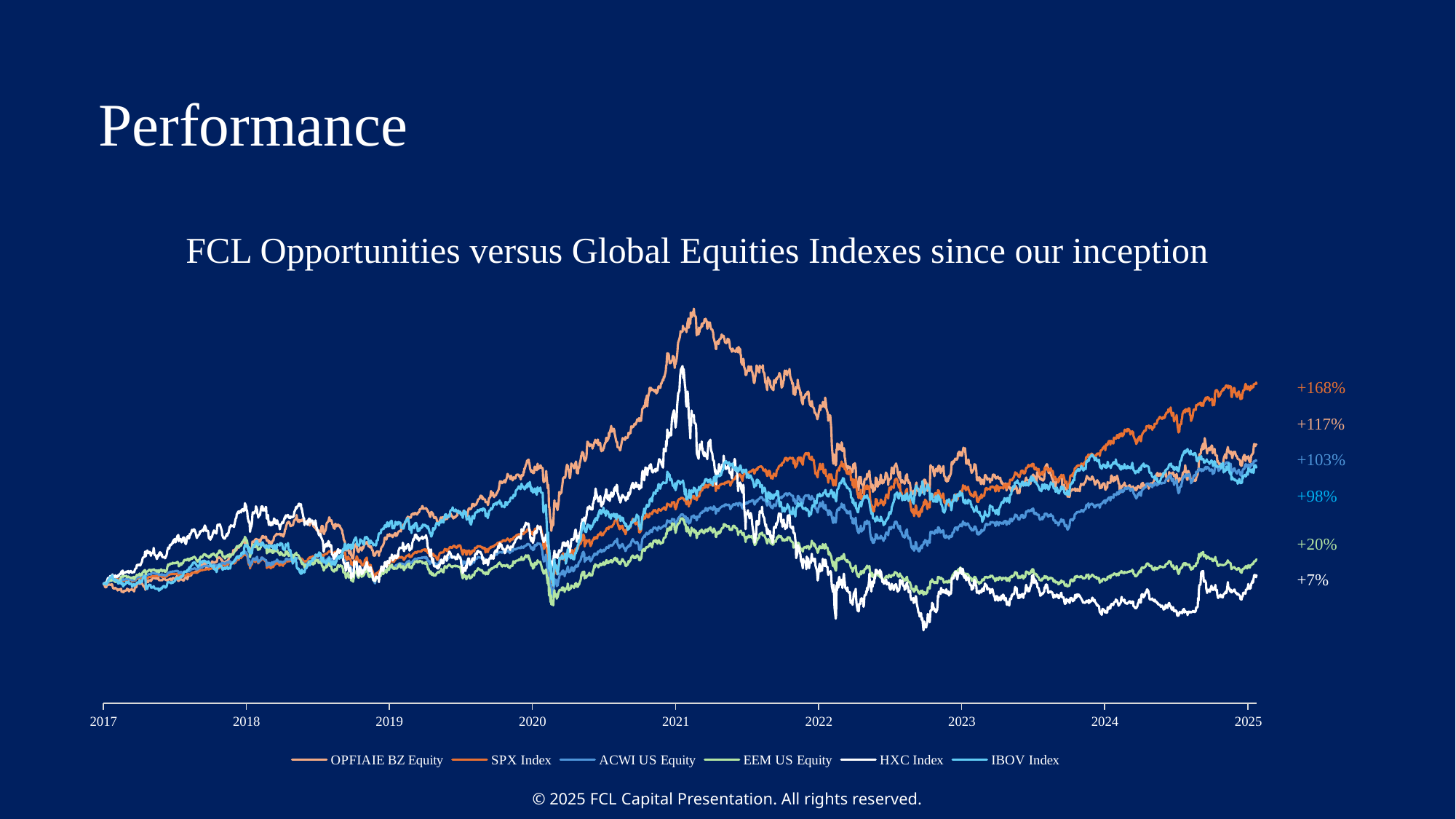
What is the highest end-of-period value labeled on the right side of the chart? +168% What kind of chart is shown on the slide? line chart At the end of the period, which is higher: EEM US Equity or HXC Index? EEM US Equity What is the difference between the two highest end-of-period labels, +168% and +117%? 51 percentage points Which series has the lowest end-of-period value labeled on the chart? HXC Index How many series does the legend list? 6 Does the white HXC Index line end higher or lower than its peak in 2021? lower What is the title of the chart? FCL Opportunities versus Global Equities Indexes since our inception What is the end-of-period value labeled for the HXC Index? +7% What is the difference between the EEM US Equity end value (+20%) and the HXC Index end value (+7%)? 13 percentage points How many year labels are shown on the x axis? 9 What is the end-of-period value labeled for EEM US Equity? +20%